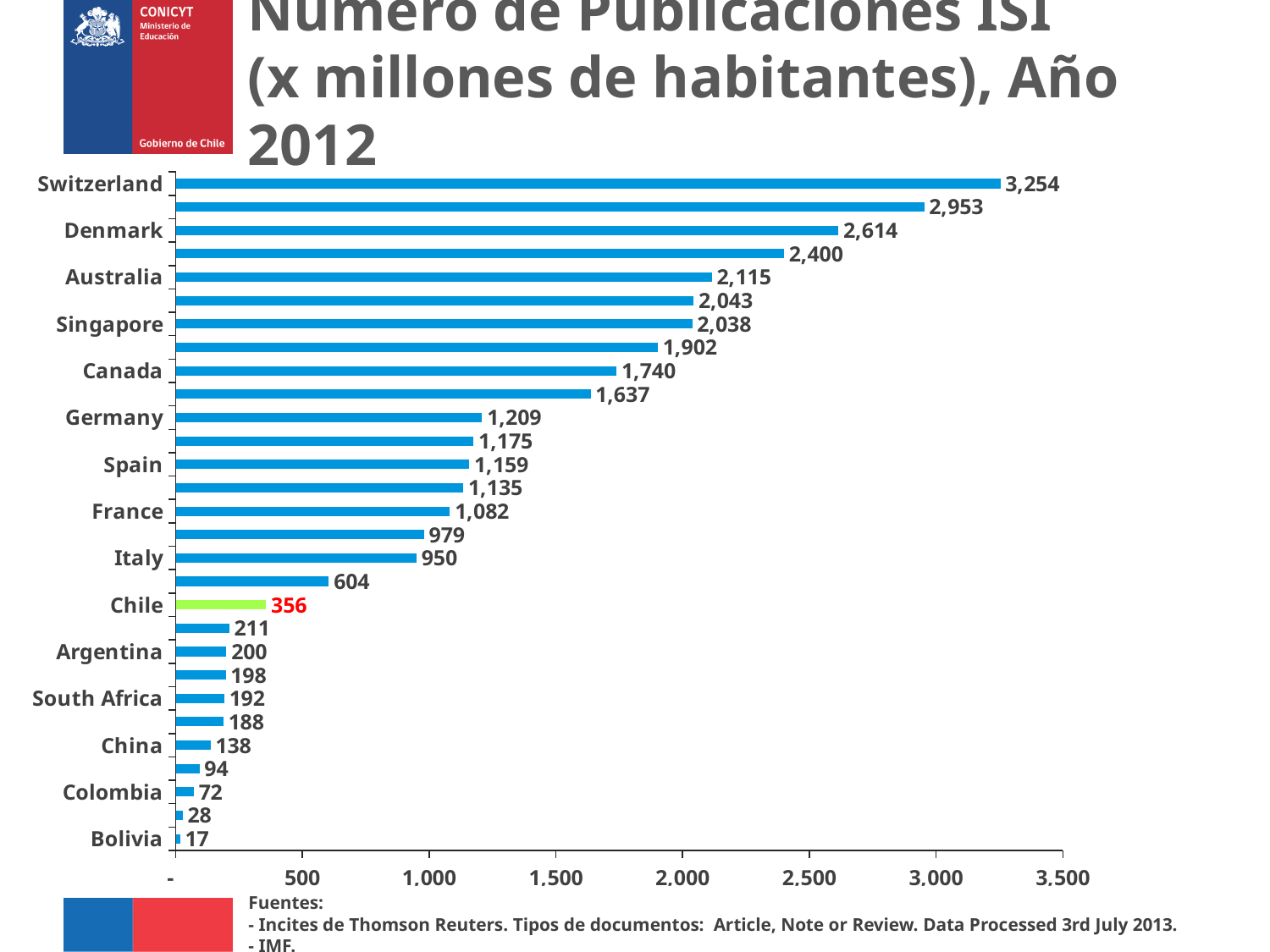
What is the difference between the values for Switzerland and Chile? 2,898 How many bars are plotted in the chart? 29 Which country has the lowest value? Bolivia What is the difference between the values for Denmark and Australia? 499 What kind of chart is shown on the slide? Bar chart What is the value for Bolivia? 17 What is the value for Canada? 1,740 Is the value for Singapore greater or less than 2,000? greater What is the value for Switzerland? 3,254 What is the value for Chile? 356 Which has a larger value, Germany or France? Germany Which country has the highest value? Switzerland